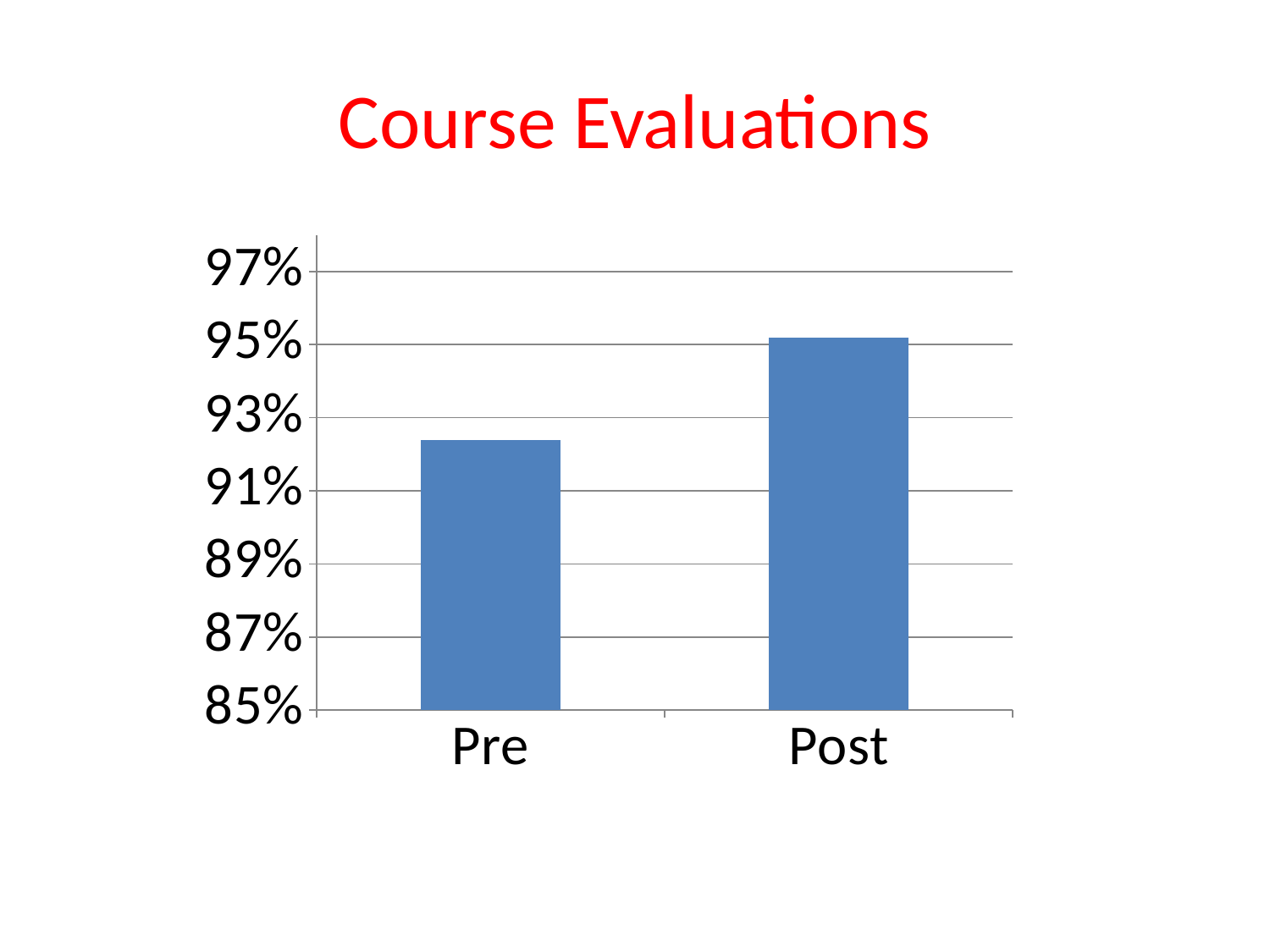
Is the value for Post greater or less than 97%? less What kind of chart is shown on the slide? bar chart Is the value for Post larger than the value for Pre? Yes Which category has the lowest value? Pre Is the value for Pre greater or less than 91%? greater How many categories are shown on the x axis? 2 What is the lowest value shown on the y axis? 85% Is the value for Pre greater or less than 93%? less Which category has the highest value, Pre or Post? Post Do the values rise or fall from Pre to Post? rise What is the title of the slide containing the chart? Course Evaluations